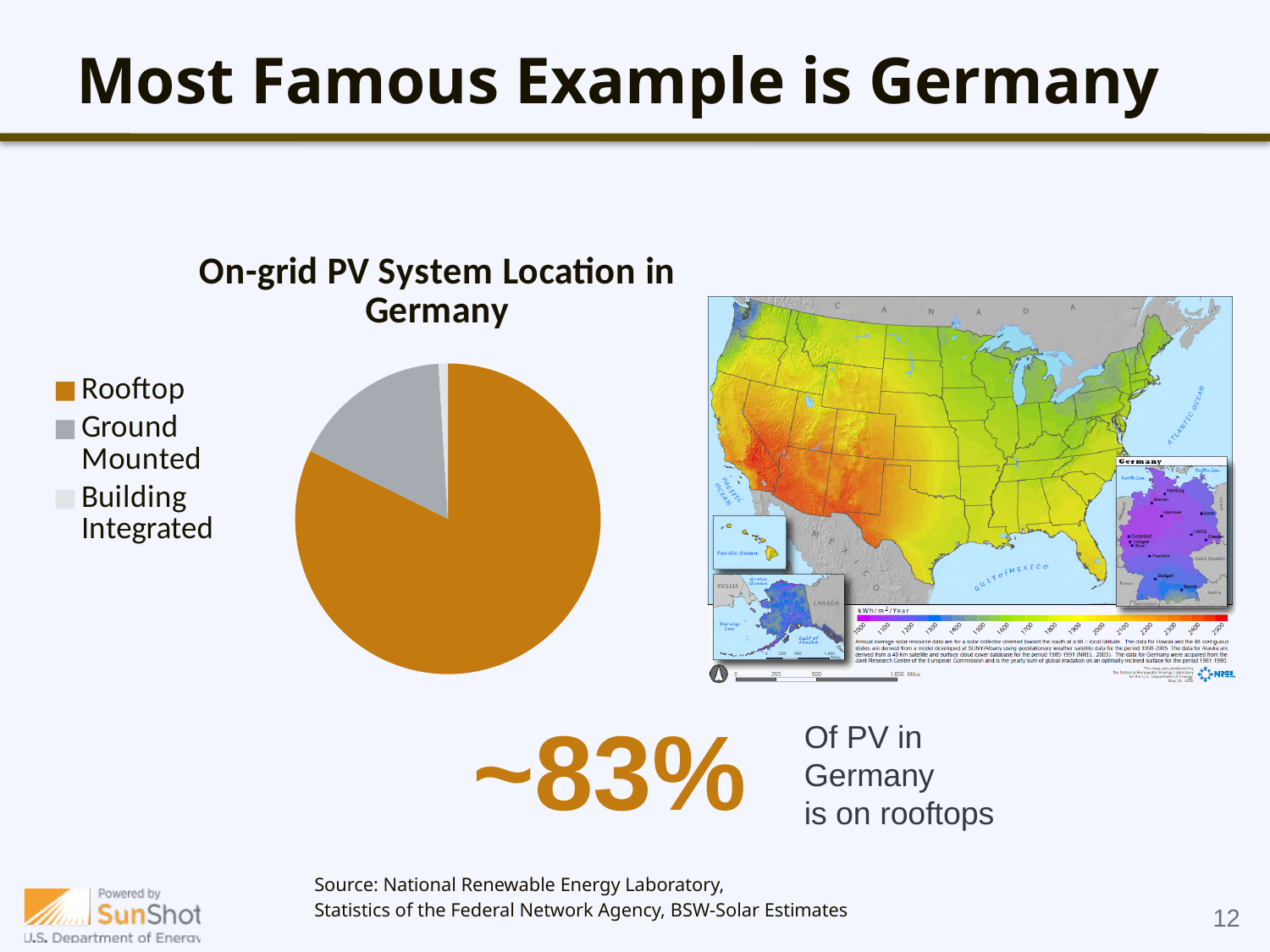
How many entries does the legend of the pie chart list? 3 What is the title of the pie chart on the slide? On-grid PV System Location in Germany Which category has the smallest slice in the pie chart "On-grid PV System Location in Germany"? Building Integrated Which category has the largest slice in the pie chart "On-grid PV System Location in Germany"? Rooftop What kind of chart is shown under the title "On-grid PV System Location in Germany"? pie chart In the pie chart, which slice is larger: Rooftop or Ground Mounted? Rooftop Which colour represents Rooftop in the pie chart? orange In the pie chart, which slice is larger: Ground Mounted or Building Integrated? Ground Mounted How many slices does the pie chart "On-grid PV System Location in Germany" have? 3